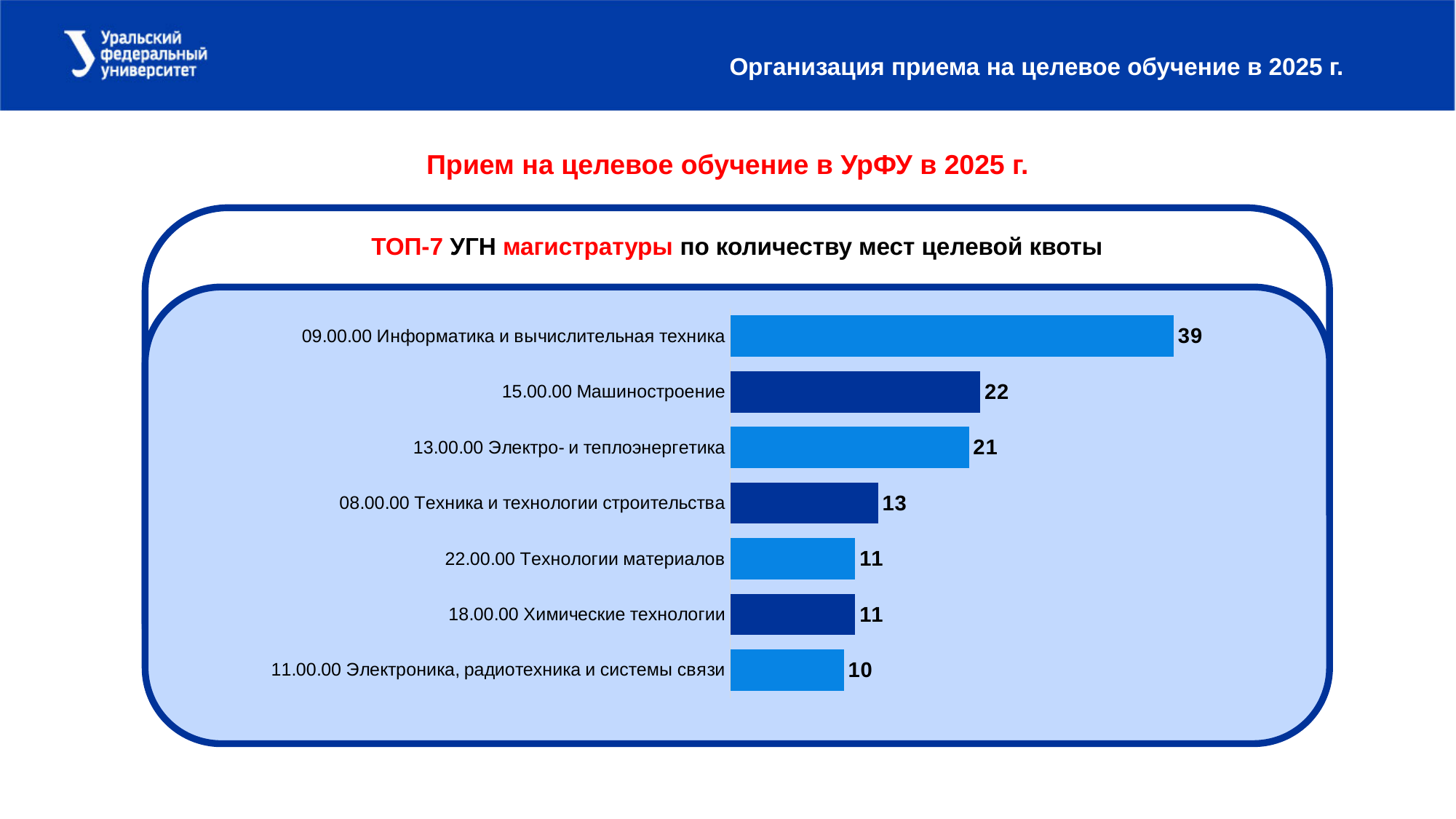
Which category has the lowest value? 11.00.00 Электроника, радиотехника и системы связи Which is larger, the value for 15.00.00 Машиностроение or the value for 22.00.00 Технологии материалов? 15.00.00 Машиностроение What is the value for 11.00.00 Электроника, радиотехника и системы связи? 10 What is the value for 08.00.00 Техника и технологии строительства? 13 What is the difference between the values for 13.00.00 Электро- и теплоэнергетика and 08.00.00 Техника и технологии строительства? 8 What is the title of the chart? ТОП-7 УГН магистратуры по количеству мест целевой квоты What is the value for 15.00.00 Машиностроение? 22 Which category has the highest value? 09.00.00 Информатика и вычислительная техника What is the difference between the values for 09.00.00 Информатика и вычислительная техника and 15.00.00 Машиностроение? 17 How many categories are shown in the chart? 7 What kind of chart is shown on the slide? bar chart What is the value for 09.00.00 Информатика и вычислительная техника? 39